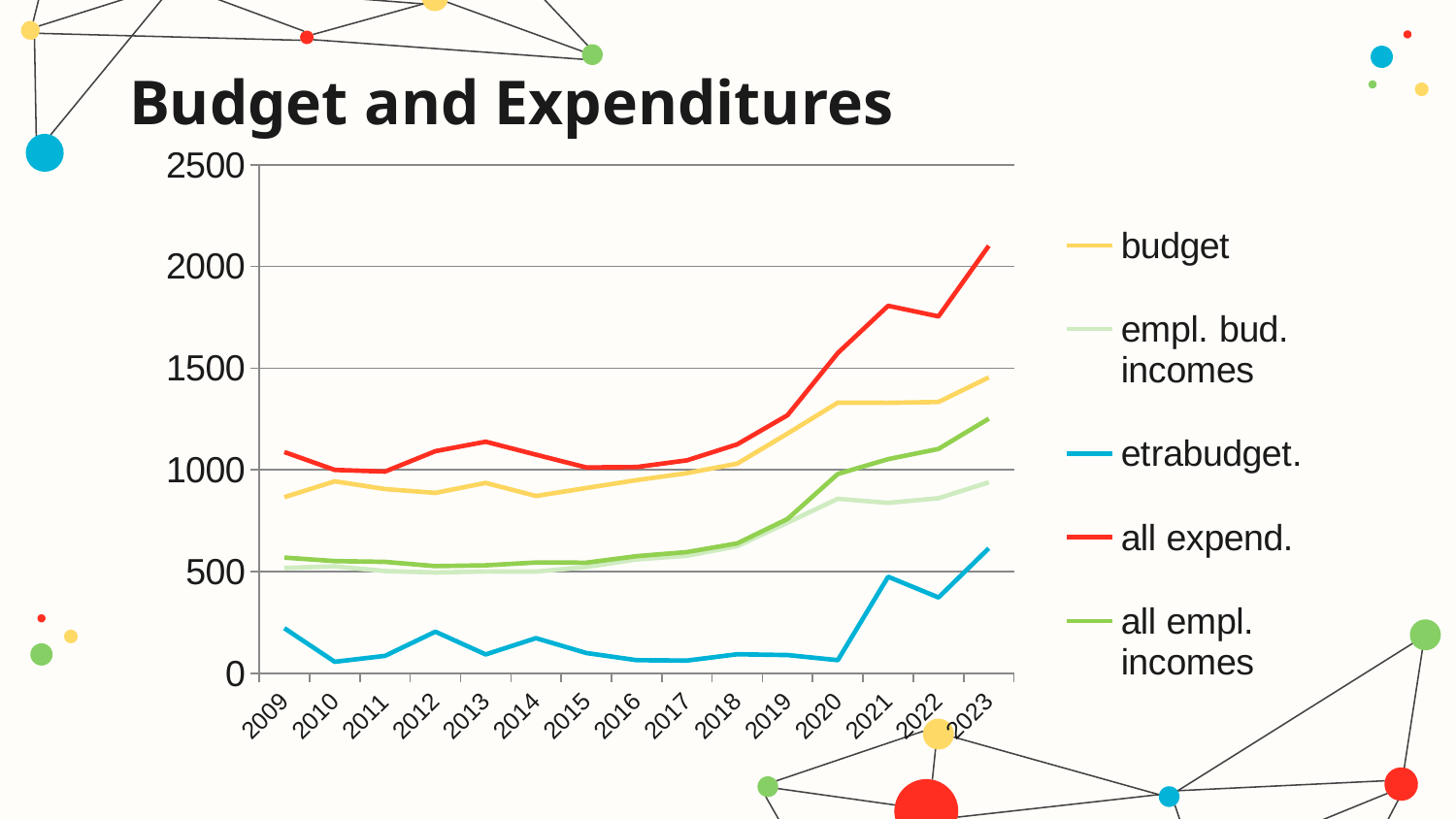
Which series has the lowest value in 2023? etrabudget. Which series has the highest value in 2023? all expend. Is the value for 'etrabudget.' in 2023 greater or less than 500? greater What kind of chart is shown on the slide? line chart How many years are shown on the x axis? 15 What is the title of the chart? Budget and Expenditures In 2020, which is larger: 'budget' or 'all expend.'? all expend. Is the value for 'all expend.' in 2023 greater or less than 2000? greater Which colour is used for the 'all expend.' series? red How many series does the legend list? 5 Is the value for 'budget' in 2009 greater or less than 1000? less